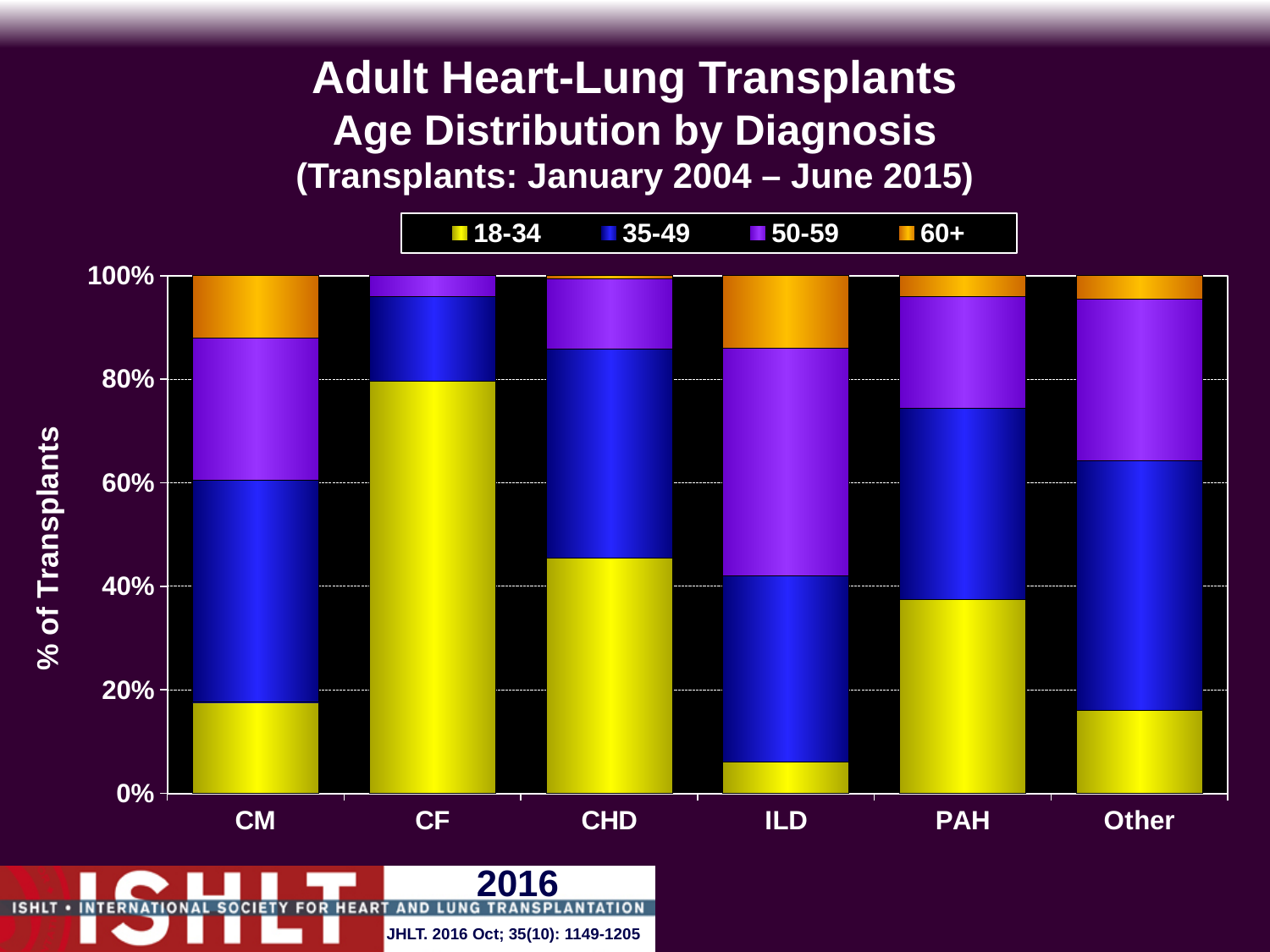
Is the 18-34 share for CHD greater or less than 40%? greater What kind of chart is shown on the slide? Stacked bar chart How many age groups does the legend list? 4 Which has the larger 18-34 share, CHD or PAH? CHD Is the 18-34 share for CF greater or less than 60%? greater Which age groups are listed in the legend? 18-34, 35-49, 50-59, 60+ Which diagnosis has the largest 50-59 share? ILD How many diagnosis categories are shown on the x axis? 6 What is the label of the y axis? % of Transplants Which diagnosis has the largest 18-34 share? CF Is the 18-34 share for ILD greater or less than 20%? less Which diagnosis has the smallest 18-34 share? ILD